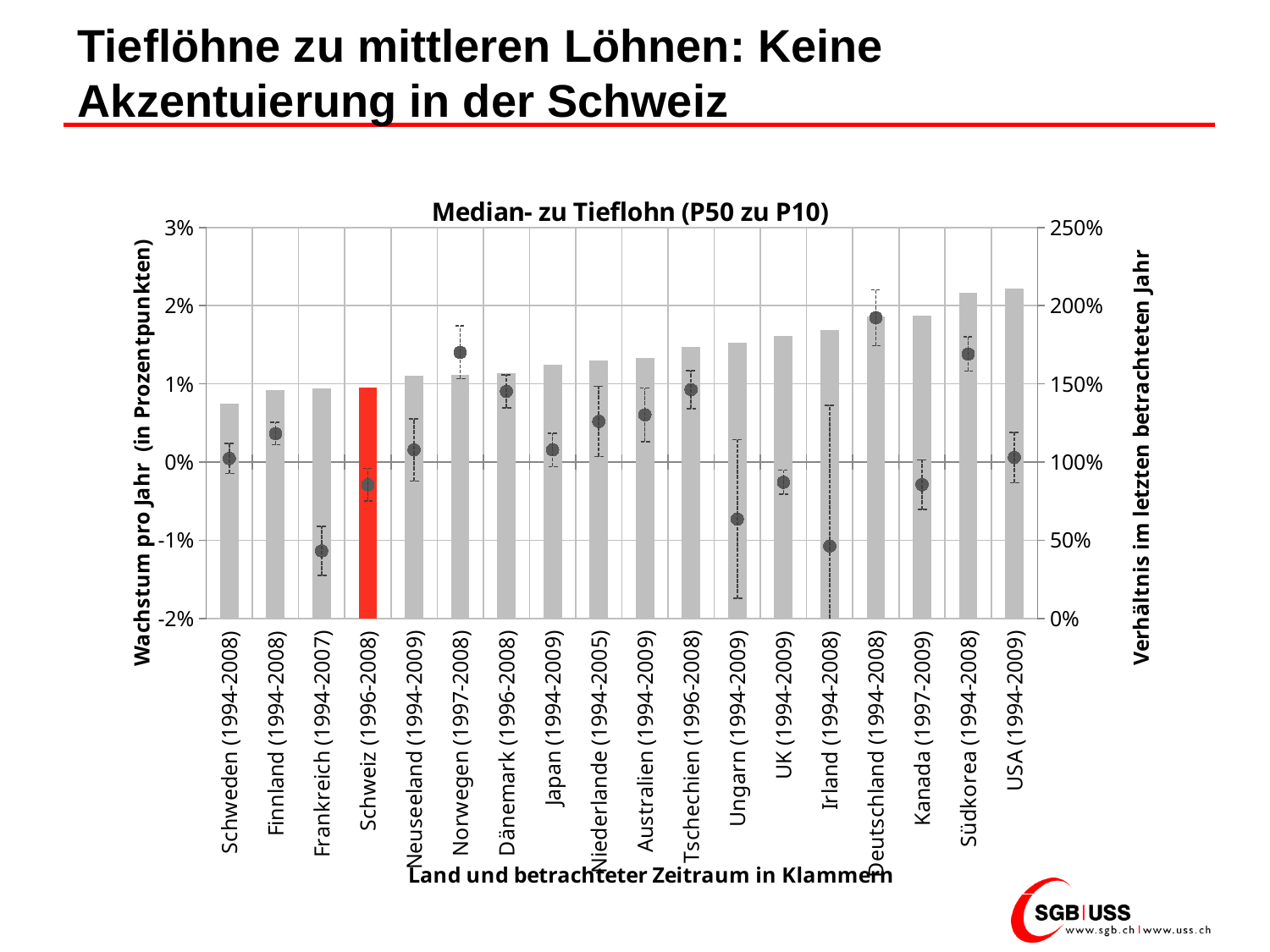
Which country has the highest dot (Wachstum pro Jahr)? Deutschland (1994-2008) Is the dot value (Wachstum pro Jahr) for Deutschland (1994-2008) greater or less than 1%? greater What kind of chart is shown on the slide? combination bar and line chart (bars with dot markers) What is the title of the chart? Median- zu Tieflohn (P50 zu P10) Which has the larger bar value, Schweden (1994-2008) or USA (1994-2009)? USA (1994-2009) How many countries are shown on the x axis of the chart? 18 Is the bar value for Schweden (1994-2008) greater or less than 150%? less Which country has the lowest bar (Verhältnis im letzten betrachteten Jahr)? Schweden (1994-2008) Do the bar values generally rise or fall from left to right along the x axis? rise Is the bar value for USA (1994-2009) greater or less than 200%? greater Which country's bar is highlighted in red? Schweiz (1996-2008)